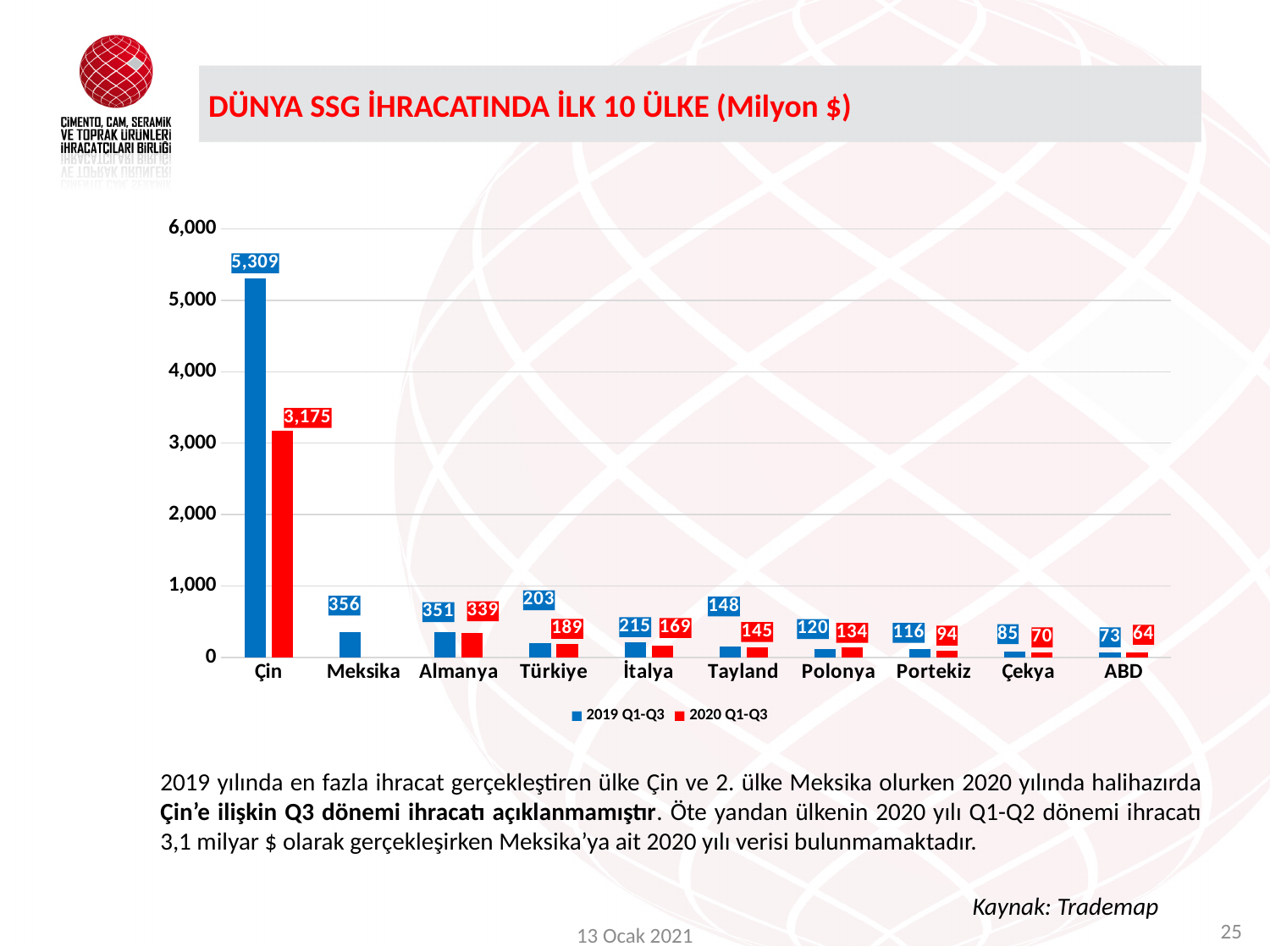
How many countries are shown on the x axis? 10 Which is larger for Polonya: the 2019 Q1-Q3 value or the 2020 Q1-Q3 value? 2020 Q1-Q3 What is the 2020 Q1-Q3 value for Portekiz? 94 What is the difference between the 2019 Q1-Q3 and 2020 Q1-Q3 values for Çin? 2,134 What is the 2019 Q1-Q3 value for Çin? 5,309 Which country has the lowest 2020 Q1-Q3 value? ABD What is the 2020 Q1-Q3 value for Almanya? 339 Is the 2020 Q1-Q3 value for Çin greater or less than 3,000? greater What kind of chart is shown on the slide? Bar chart Which country has the highest 2019 Q1-Q3 value? Çin What is the 2019 Q1-Q3 value for Meksika? 356 How many series does the legend list? 2